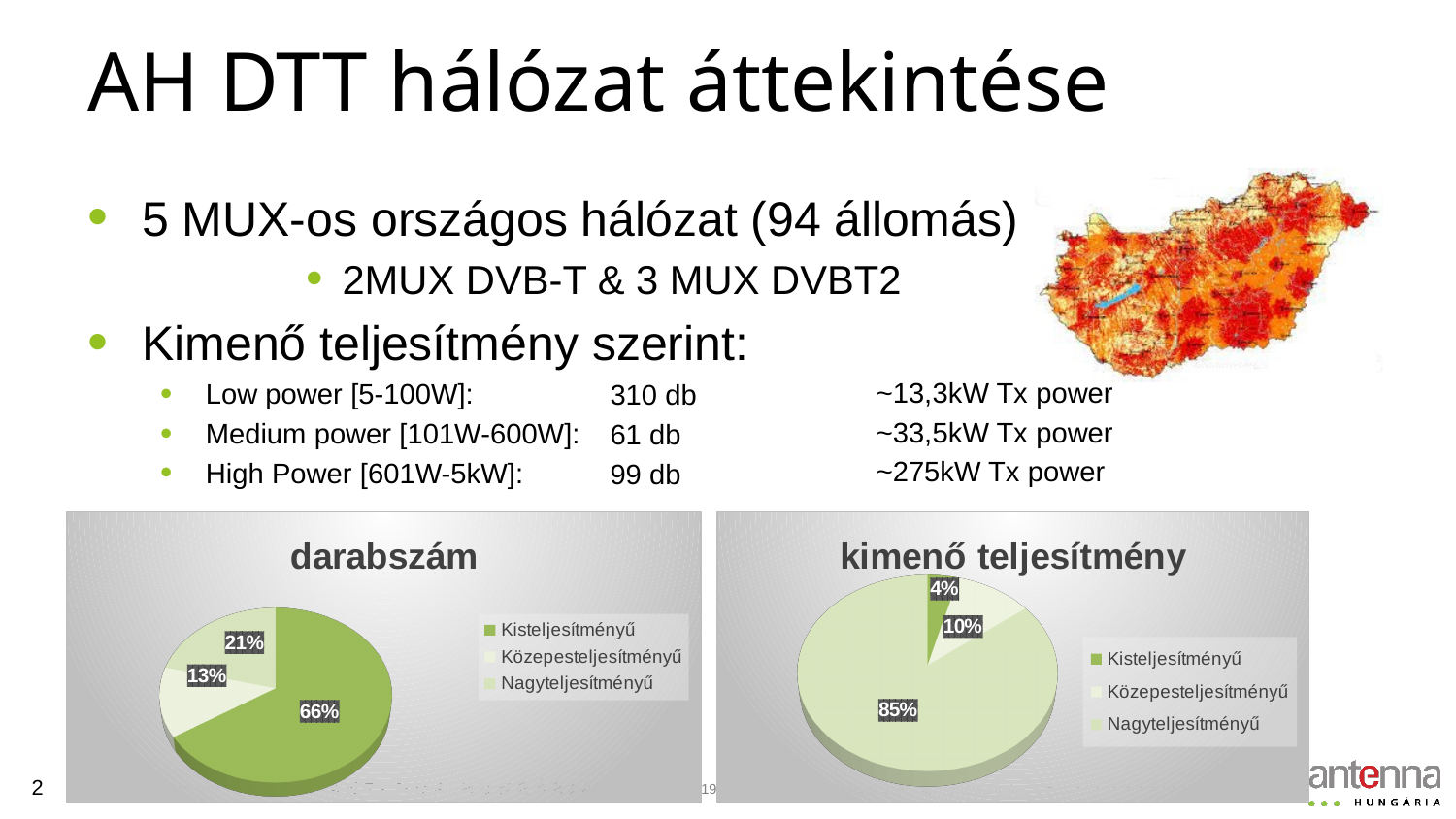
In the "kimenő teljesítmény" chart, what share does Kisteljesítményű have? 4% In the "kimenő teljesítmény" chart, what share does Nagyteljesítményű have? 85% In the "darabszám" chart, what is the difference between the Kisteljesítményű and Nagyteljesítményű shares? 45% In the "darabszám" chart, which category has the largest slice? Kisteljesítményű In the "darabszám" chart, what share does Kisteljesítményű have? 66% In the "kimenő teljesítmény" chart, which category has the largest slice? Nagyteljesítményű How many categories does the legend of the "kimenő teljesítmény" chart list? 3 What type of chart is the "darabszám" chart? pie chart In the "darabszám" chart, which category has the smallest slice? Közepesteljesítményű